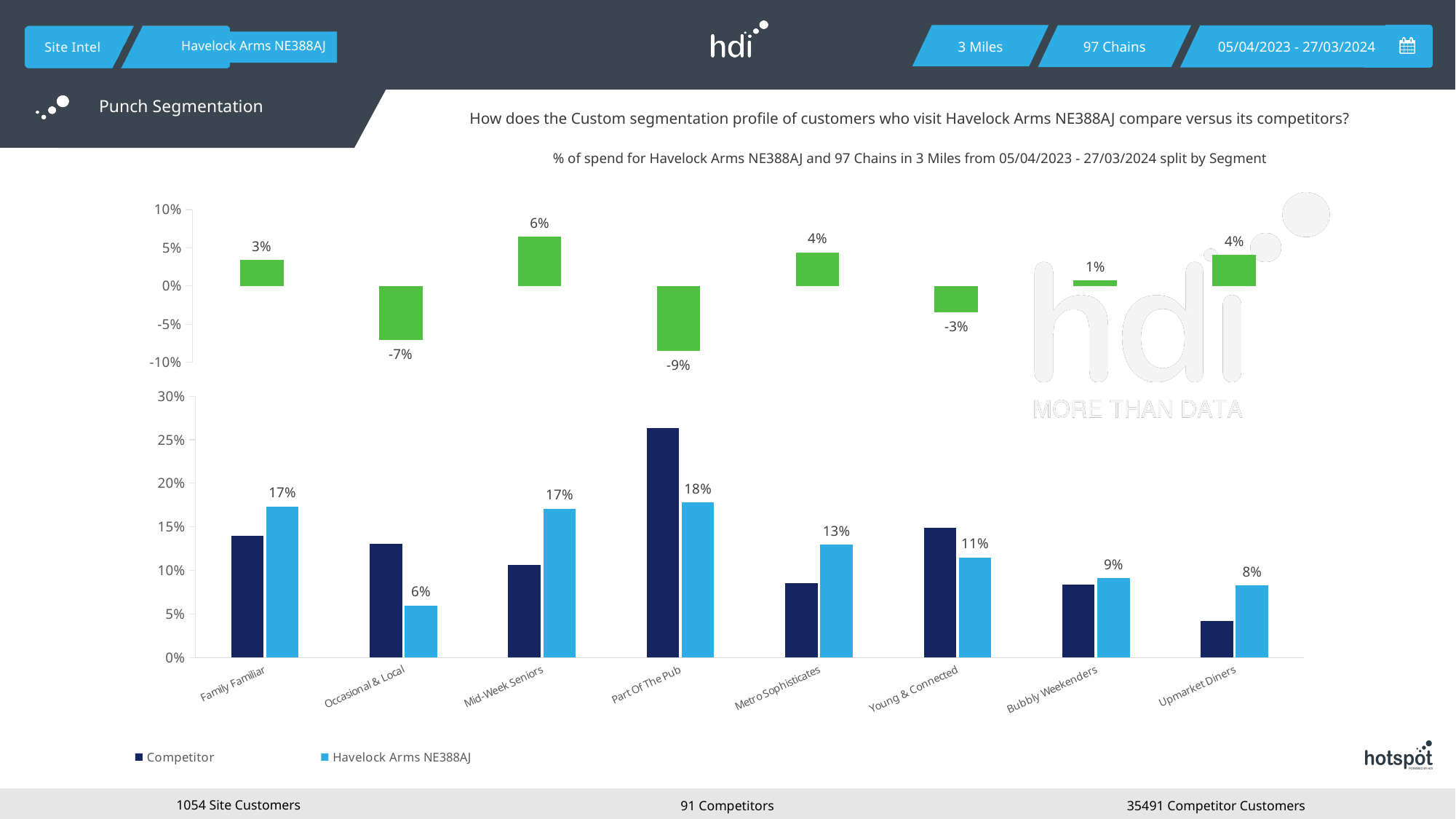
In the bottom chart, which segment has the highest Competitor value? Part Of The Pub In the bottom chart, which is larger for Young & Connected: the Competitor value or the Havelock Arms NE388AJ value? Competitor In the bottom chart, what is the difference between the Havelock Arms NE388AJ values for Part Of The Pub and Occasional & Local? 12% How many series does the legend of the bottom chart list? 2 In the bottom chart, is the Competitor value for Part Of The Pub greater or less than 25%? greater In the bottom chart, what is the Havelock Arms NE388AJ value for Part Of The Pub? 18% In the bottom chart, what is the Havelock Arms NE388AJ value for Occasional & Local? 6% How many segments are shown on the x axis of the bottom chart? 8 In the bottom chart, which segment has the highest Havelock Arms NE388AJ value? Part Of The Pub In the top chart, what is the value shown for Part Of The Pub? -9% In the top chart, what is the value shown for Mid-Week Seniors? 6% In the top chart, which segment has the lowest value? Part Of The Pub